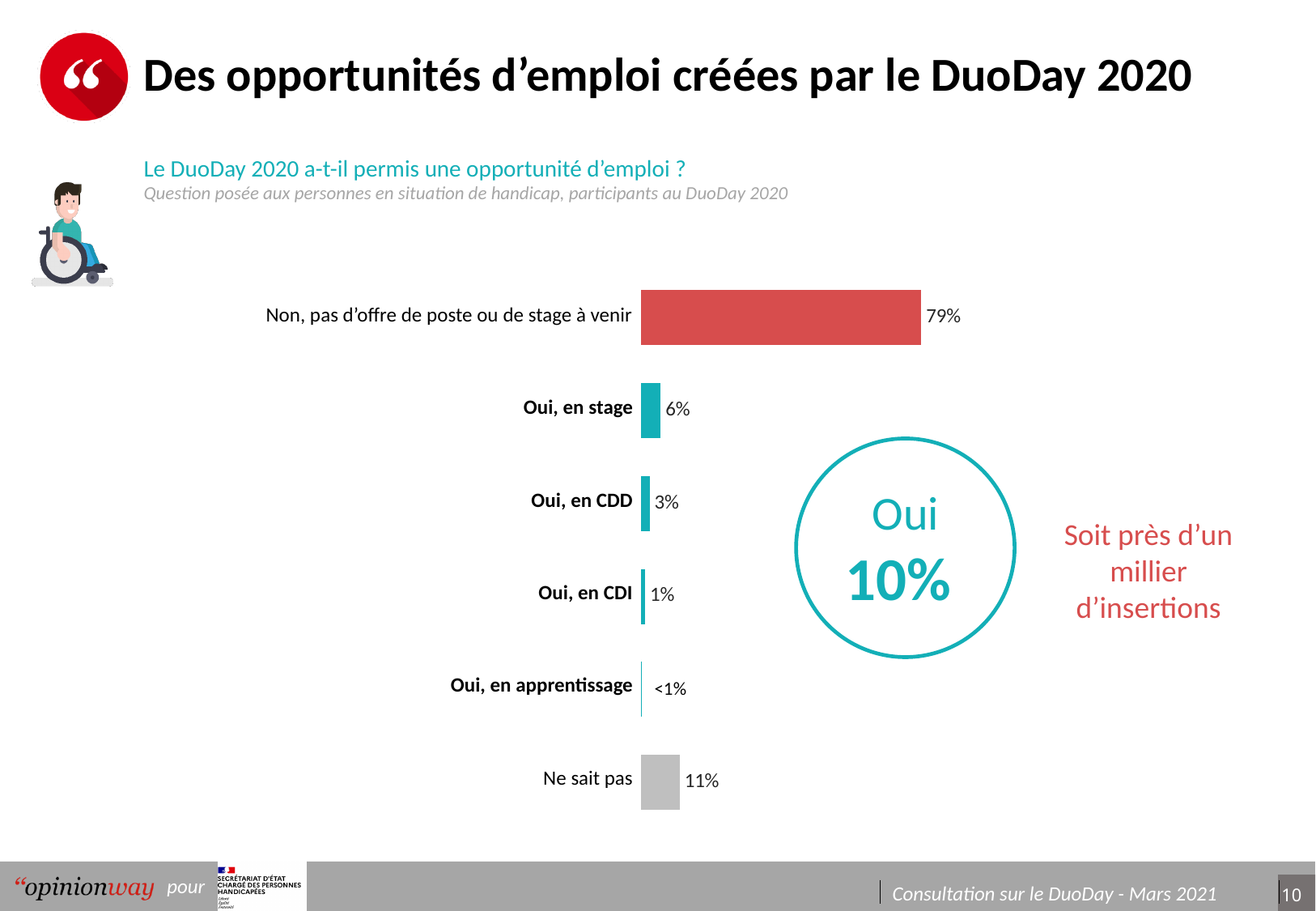
Which is larger, "Oui, en CDD" or "Oui, en CDI"? Oui, en CDD What is the difference between "Ne sait pas" and "Oui, en stage"? 5% What kind of chart is shown on the slide? Bar chart What total percentage is shown in the circle for "Oui"? 10% What is the value shown for "Oui, en apprentissage"? <1% What is the value for "Non, pas d'offre de poste ou de stage à venir"? 79% What is the value for "Oui, en stage"? 6% How many categories are shown in the bar chart? 6 What is the value for "Ne sait pas"? 11% What is the value for "Oui, en CDD"? 3% Which category has the highest value? Non, pas d'offre de poste ou de stage à venir What is the difference between "Non, pas d'offre de poste ou de stage à venir" and "Ne sait pas"? 68%